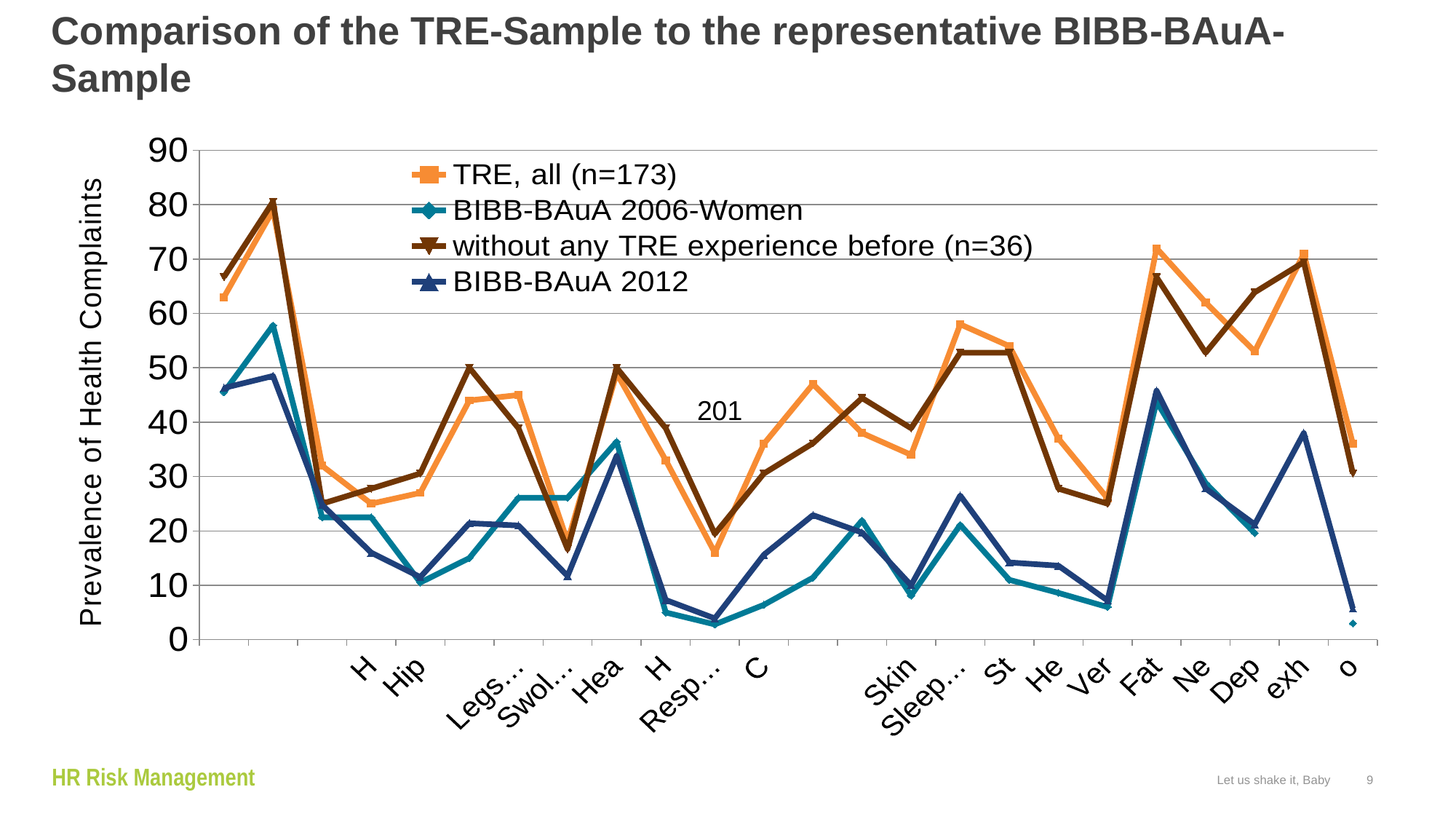
Is the value for "TRE, all (n=173)" at Skin greater or less than 20? greater At Dep, which is larger: "TRE, all (n=173)" or "without any TRE experience before (n=36)"? without any TRE experience before (n=36) At Ne, which is larger: "TRE, all (n=173)" or "without any TRE experience before (n=36)"? TRE, all (n=173) Is the value for "BIBB-BAuA 2012" at exh greater or less than 30? greater Is the value for "BIBB-BAuA 2012" at Hip greater or less than 20? less What is the title of the vertical axis? Prevalence of Health Complaints Which series in the legend has n=36? without any TRE experience before (n=36) How many series does the legend list? 4 What kind of chart is shown on the slide? line chart